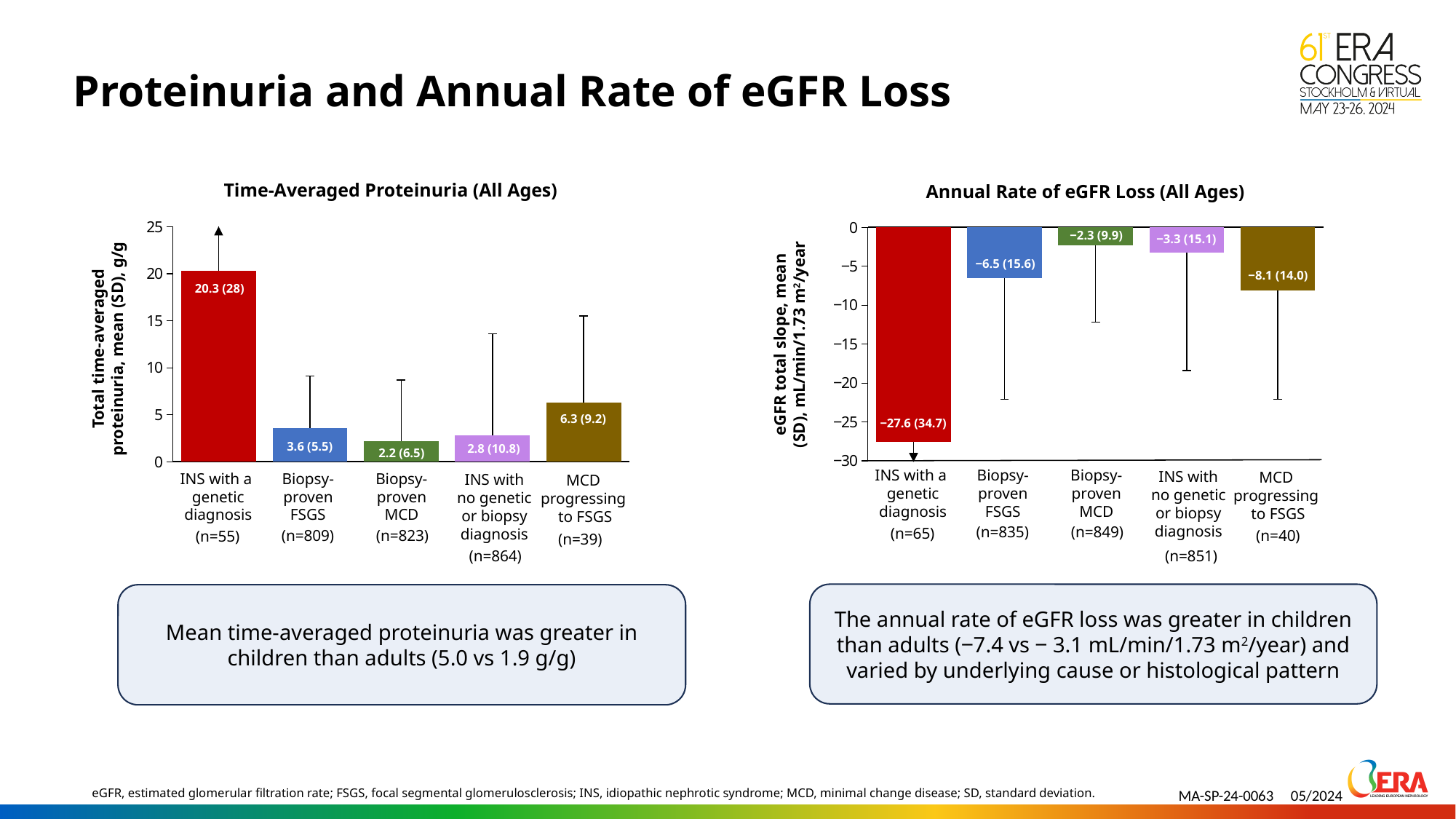
In the Time-Averaged Proteinuria (All Ages) chart, which category has the highest mean value? INS with a genetic diagnosis In the Time-Averaged Proteinuria (All Ages) chart, what is the data label for MCD progressing to FSGS? 6.3 (9.2) In the Annual Rate of eGFR Loss (All Ages) chart, what is the data label for INS with no genetic or biopsy diagnosis? −3.3 (15.1) In the Annual Rate of eGFR Loss (All Ages) chart, which category has the smallest eGFR loss (mean closest to zero)? Biopsy-proven MCD In the Time-Averaged Proteinuria (All Ages) chart, what is the data label for INS with a genetic diagnosis? 20.3 (28) What type of chart is the Annual Rate of eGFR Loss (All Ages) chart? Bar chart In the Annual Rate of eGFR Loss (All Ages) chart, which category has the largest eGFR loss (most negative mean)? INS with a genetic diagnosis In the Annual Rate of eGFR Loss (All Ages) chart, is the mean eGFR loss larger for Biopsy-proven FSGS or for MCD progressing to FSGS? MCD progressing to FSGS In the Time-Averaged Proteinuria (All Ages) chart, which category has the lowest mean value? Biopsy-proven MCD In the Time-Averaged Proteinuria (All Ages) chart, what is the difference between the mean values for INS with a genetic diagnosis and MCD progressing to FSGS? 14.0 In the Time-Averaged Proteinuria (All Ages) chart, how many categories are shown? 5 In the Annual Rate of eGFR Loss (All Ages) chart, what is the data label for Biopsy-proven FSGS? −6.5 (15.6)